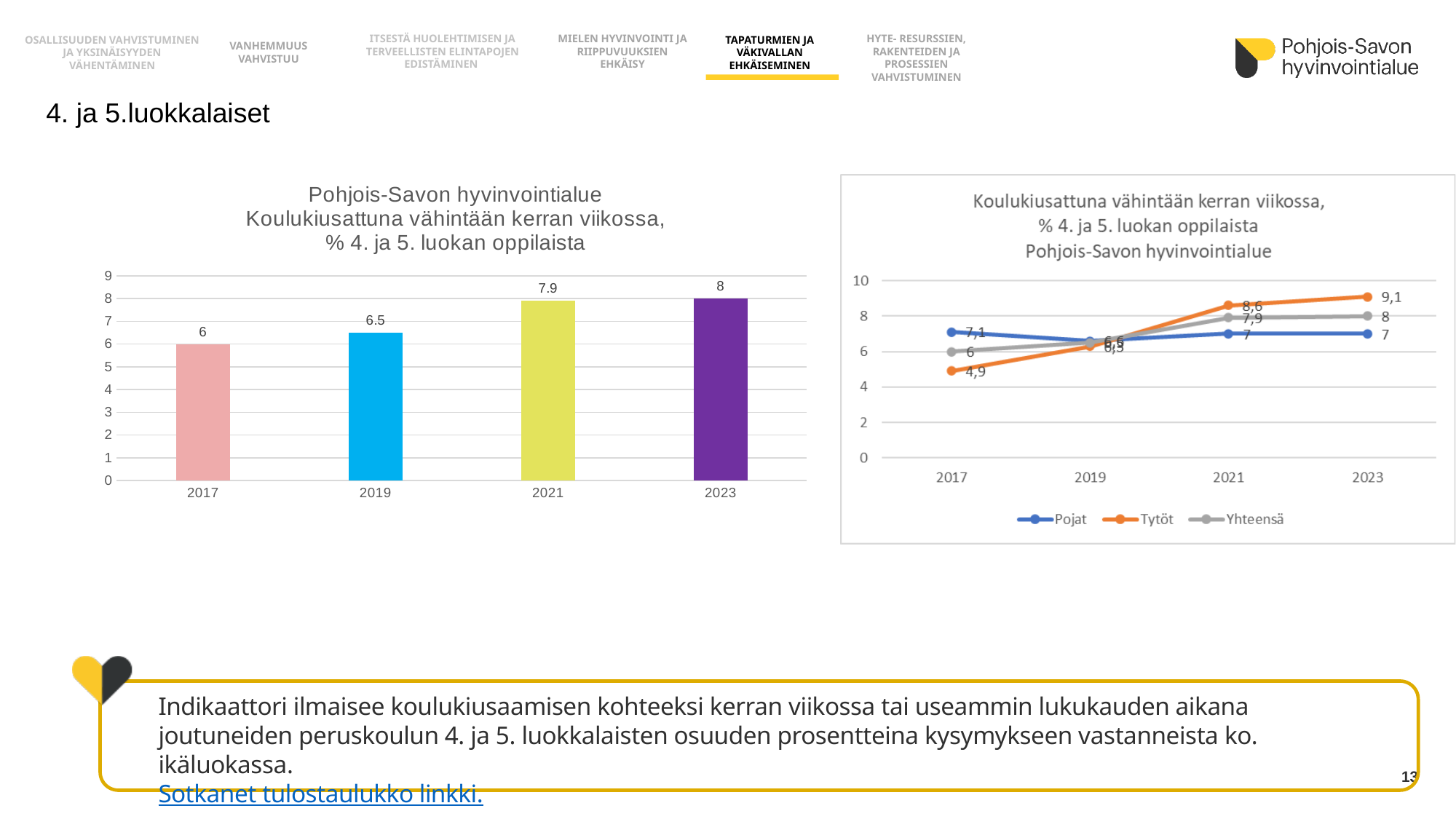
What kind of chart is the chart on the left? bar chart In the right line chart, what is the value for Tytöt in 2023? 9,1 In the left bar chart, do the values rise or fall from 2017 to 2023? rise In the right line chart, which series is higher in 2021, Pojat or Tytöt? Tytöt How many series does the legend of the right line chart list? 3 In the left bar chart, which year has the highest value? 2023 In the left bar chart, what is the value for 2017? 6 In the right line chart, what is the value for Tytöt in 2017? 4,9 In the left bar chart, what is the difference between the values for 2023 and 2017? 2 In the left bar chart, what is the value for 2021? 7.9 In the left bar chart, which year has the lowest value? 2017 In the right line chart, what is the value for Pojat in 2017? 7,1